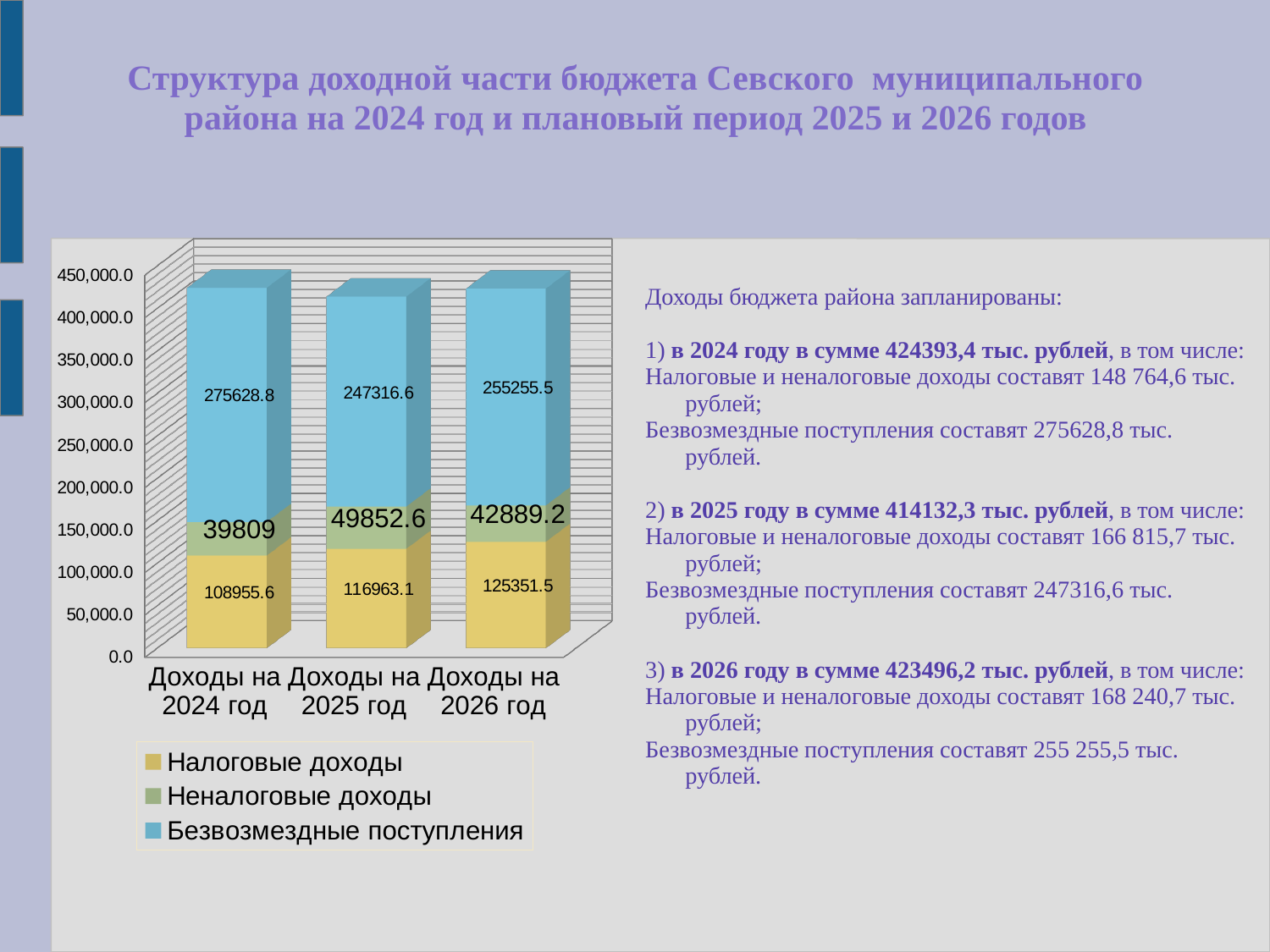
What is the value of Налоговые доходы for Доходы на 2026 год? 125351.5 How many categories are shown on the x axis? 3 What is the value of Неналоговые доходы for Доходы на 2025 год? 49852.6 What is the total of the stacked bar for Доходы на 2024 год? 424393.4 In which year is the Безвозмездные поступления value the lowest? Доходы на 2025 год What is the total of the stacked bar for Доходы на 2025 год? 414132.3 What is the difference between Налоговые доходы for 2026 and for 2024? 16395.9 How many series does the legend list? 3 In which year is the Неналоговые доходы value the highest? Доходы на 2025 год What is the value of Безвозмездные поступления for Доходы на 2024 год? 275628.8 Which is larger: Безвозмездные поступления for 2024 or for 2026? 2024 What kind of chart is shown on the slide? Stacked bar chart